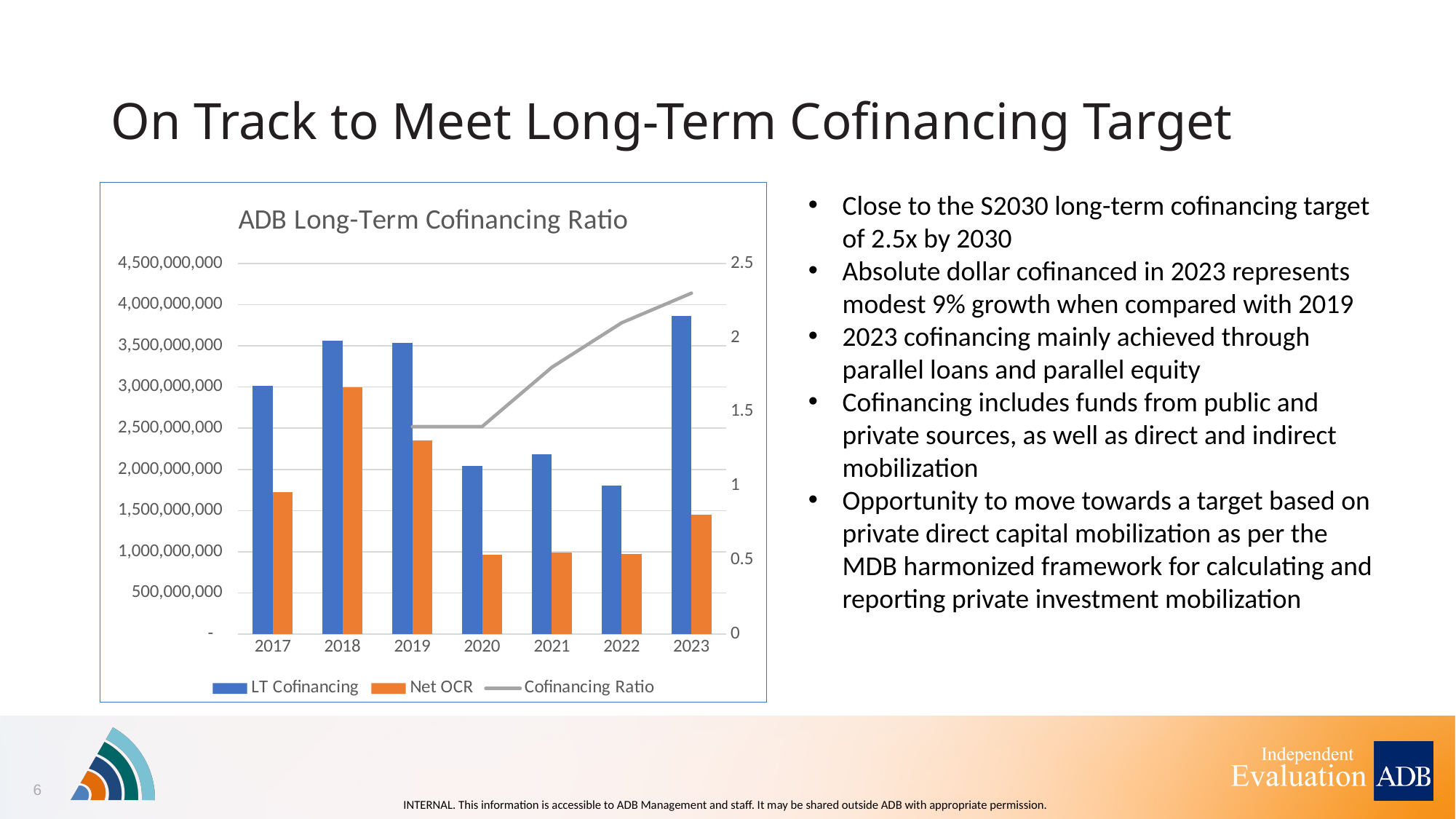
Which year has the highest LT Cofinancing bar? 2023 Is the Cofinancing Ratio for 2023 greater or less than 2? greater Which is larger in 2017, LT Cofinancing or Net OCR? LT Cofinancing Is the LT Cofinancing value for 2023 greater or less than 3,500,000,000? greater What type of chart is shown on the slide? Combination bar and line chart Does the Cofinancing Ratio line rise or fall from 2020 to 2023? rise How many series does the chart legend list? 3 Which year has the highest Net OCR bar? 2018 How many years are shown on the x axis of the chart? 7 Which year has the lowest LT Cofinancing bar? 2022 What is the title of the chart? ADB Long-Term Cofinancing Ratio